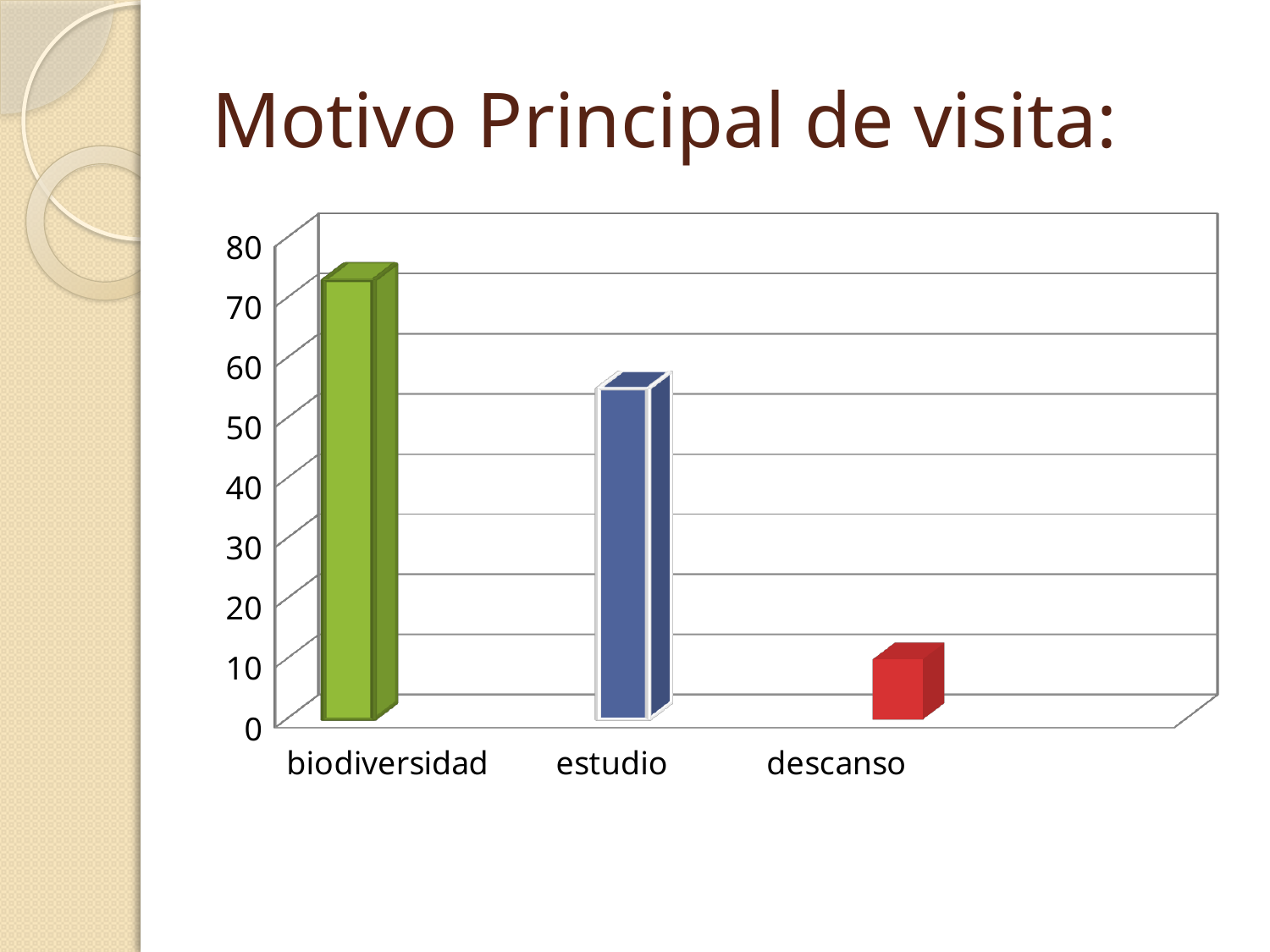
Which is larger, the value for biodiversidad or the value for estudio? biodiversidad What is the title of the slide containing the chart? Motivo Principal de visita: How many categories are shown on the x axis of the chart? 3 Which is larger, the value for estudio or the value for descanso? estudio Is the value for estudio greater or less than 60? less Which category has the lowest bar in the chart? descanso What kind of chart is shown on the slide? bar chart Is the value for biodiversidad greater or less than 60? greater Is the value for estudio greater or less than 50? greater Which category has the highest bar in the chart? biodiversidad Do the bar values rise or fall from left to right along the x axis? fall